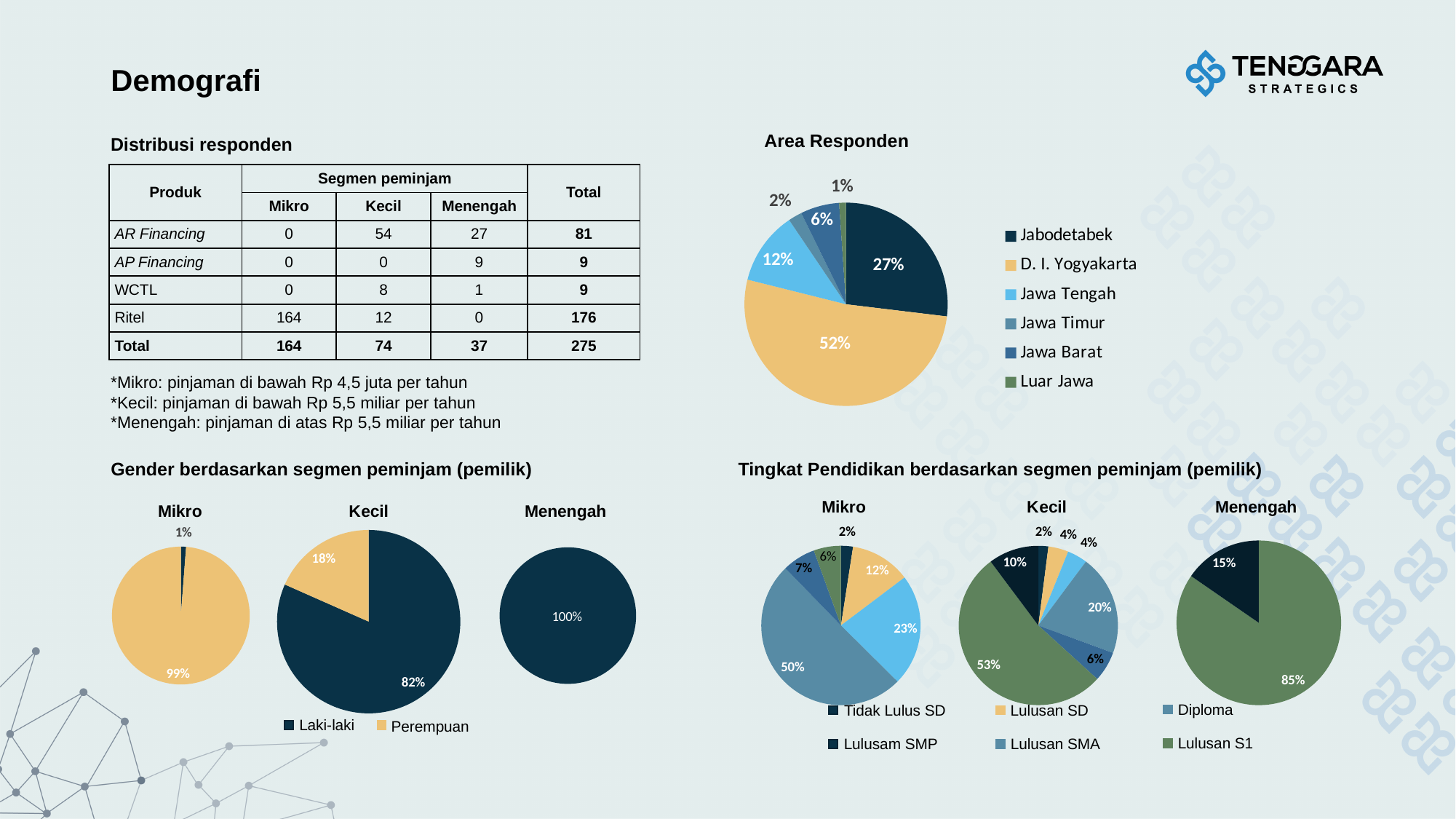
In the Gender berdasarkan segmen peminjam (pemilik) section, what percentage of the Mikro segment is Perempuan? 99% In the Gender berdasarkan segmen peminjam (pemilik) section, what percentage of the Kecil segment is Laki-laki? 82% In the Area Responden pie chart, what percentage of respondents are from Jabodetabek? 27% How many areas does the legend of the Area Responden chart list? 6 In the Area Responden pie chart, what is the difference between the shares of D. I. Yogyakarta and Jawa Tengah? 40% In the Tingkat Pendidikan berdasarkan segmen peminjam (pemilik) section, what percentage of the Menengah segment is Lulusan S1? 85% What type of chart is used for Area Responden? Pie chart In the Tingkat Pendidikan berdasarkan segmen peminjam (pemilik) section, what percentage of the Kecil segment is Lulusan S1? 53% In the Area Responden pie chart, which area has the smallest share? Luar Jawa In the Area Responden pie chart, which area has the largest share? D. I. Yogyakarta In the Gender berdasarkan segmen peminjam (pemilik) section, what percentage of the Menengah segment is Laki-laki? 100% In the Area Responden pie chart, what percentage of respondents are from D. I. Yogyakarta? 52%